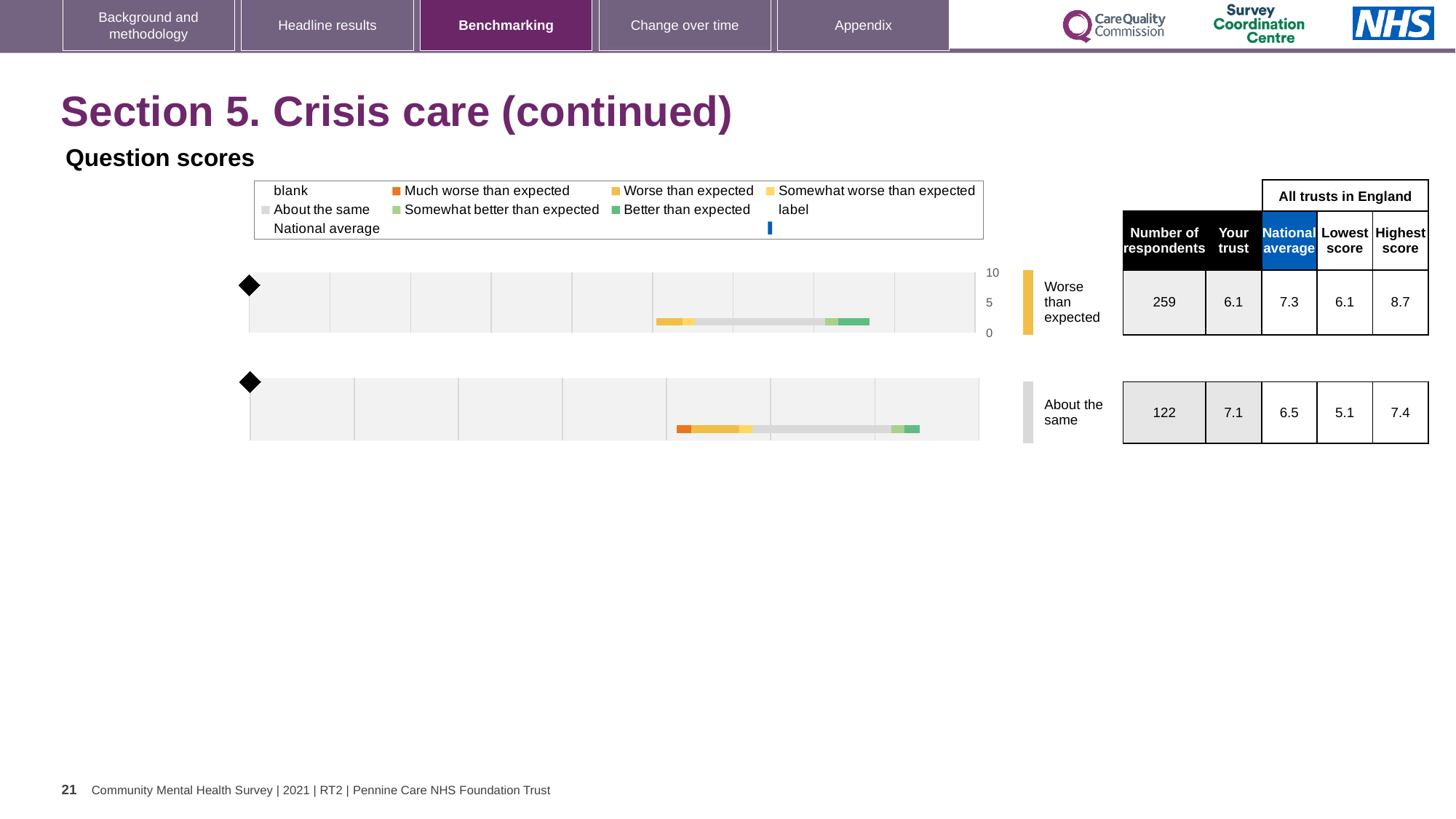
For the bottom chart, rated 'About the same', what is the Lowest score among all trusts in England? 5.1 How many question score charts are shown on the slide? 2 For the top chart, rated 'Worse than expected', what is the Highest score among all trusts in England? 8.7 For the top chart, rated 'Worse than expected', how many respondents are there? 259 For the top chart, rated 'Worse than expected', what is the National average score? 7.3 What kind of chart is used to show the question scores on this slide? Bar chart For the top chart, rated 'Worse than expected', what is the difference between the National average and Your trust score? 1.2 For the bottom chart, rated 'About the same', which is larger: Your trust score or the National average? Your trust For the bottom chart, rated 'About the same', what is the score for Your trust? 7.1 What rating label is shown next to the top chart? Worse than expected For the top chart, rated 'Worse than expected', what is the score for Your trust? 6.1 For the bottom chart, rated 'About the same', how many respondents are there? 122